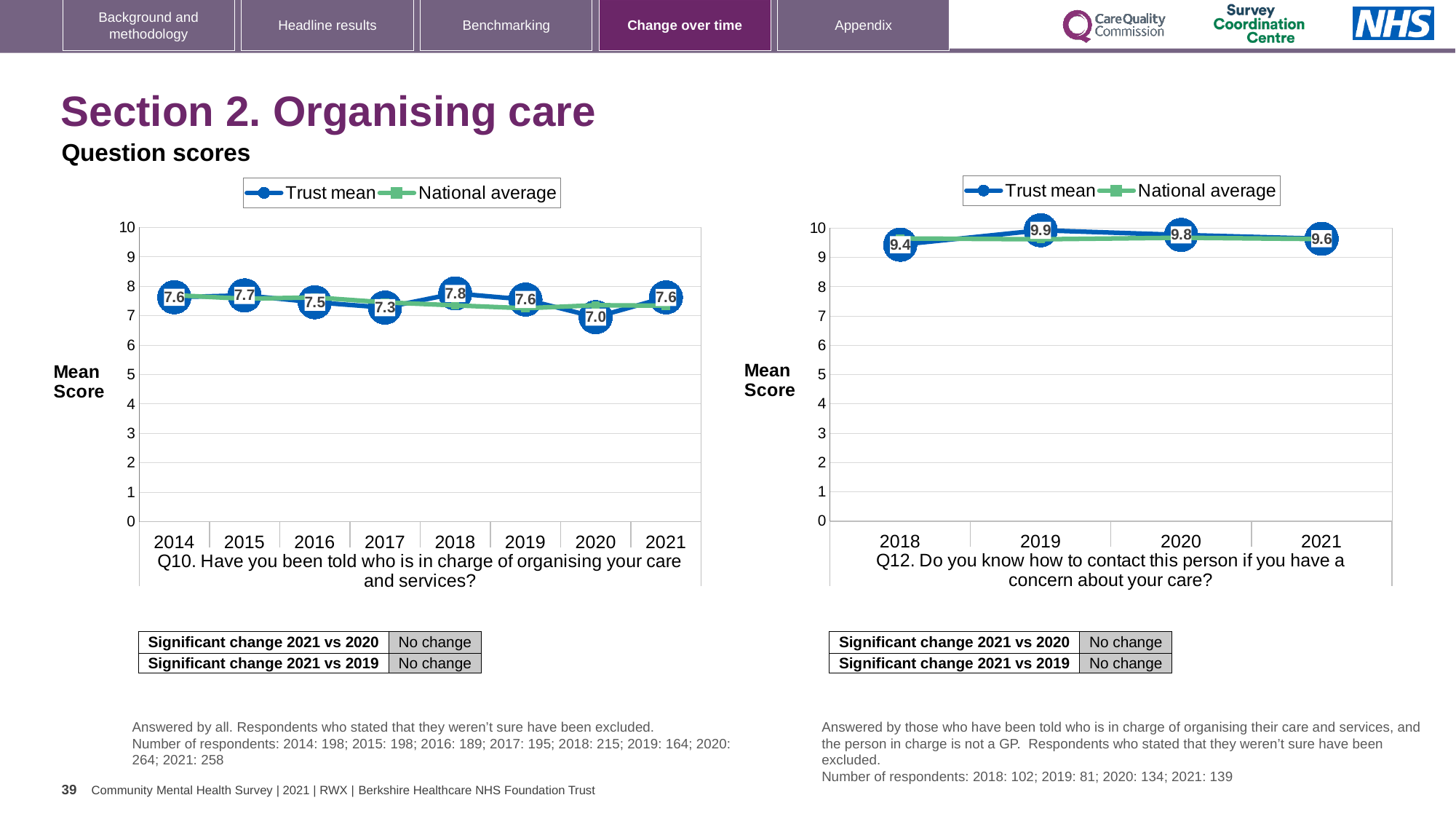
On the Q10 chart, what is the difference between the Trust mean scores for 2018 and 2020? 0.8 On the Q10 chart, what is the Trust mean score for 2020? 7.0 On the Q12 chart, what is the Trust mean score for 2021? 9.6 On the Q10 chart, which year has the lowest Trust mean score? 2020 On the Q12 chart, which year has the lowest Trust mean score? 2018 On the Q10 chart, which year has the highest Trust mean score? 2018 On the Q12 chart, how many series does the legend list? 2 On the Q12 chart, is the Trust mean score for 2019 larger or smaller than the score for 2021? larger On the Q10 chart, what is the Trust mean score for 2018? 7.8 On the Q12 chart, what is the Trust mean score for 2019? 9.9 On the Q10 chart, how many years are plotted on the x axis? 8 What type of chart is the Q10 chart? line chart